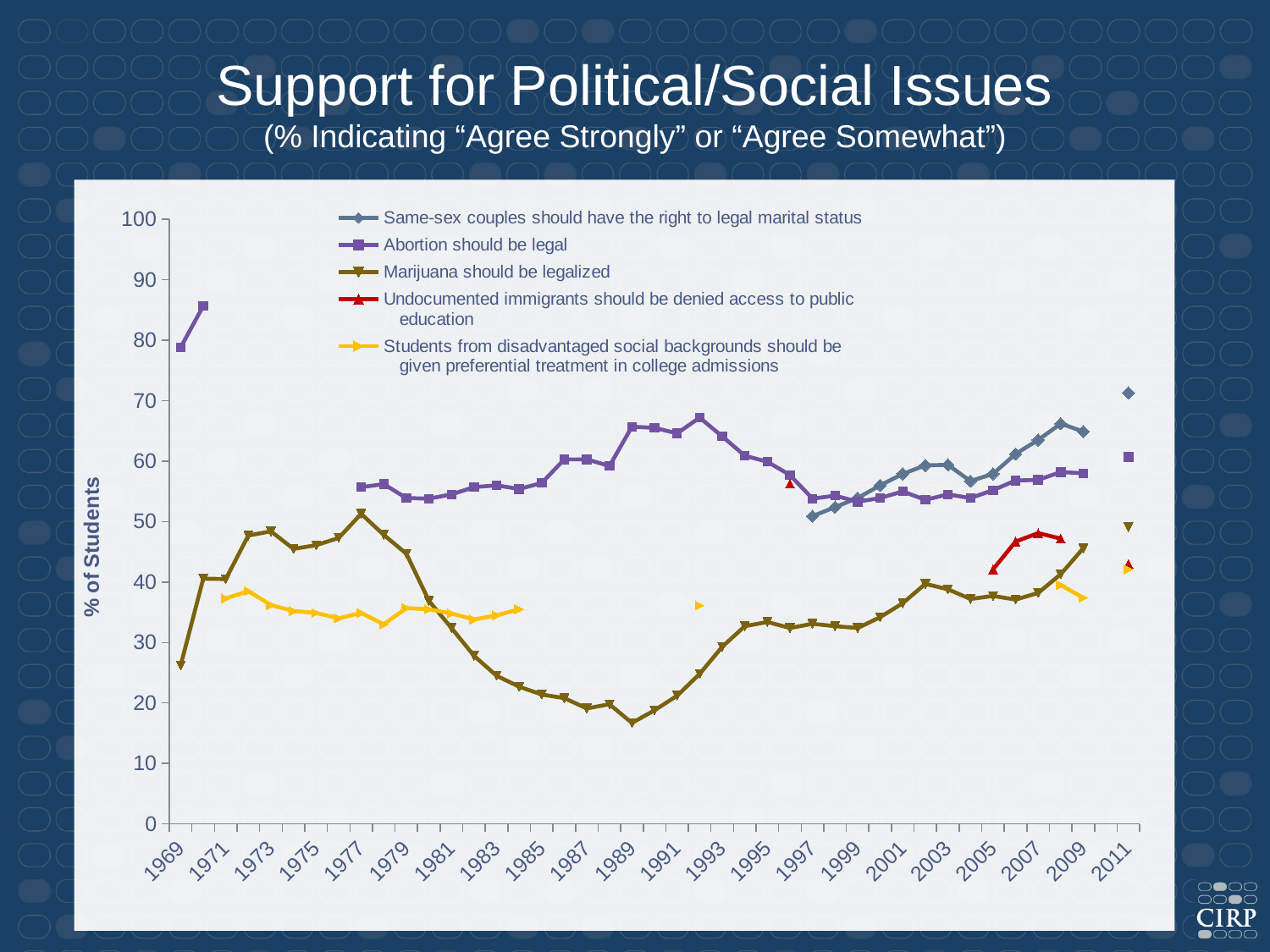
Is the value for 'Marijuana should be legalized' in 1989 greater or less than 20? less Is the value for 'Marijuana should be legalized' in 1969 greater or less than 30? less In 2011, which is higher: 'Same-sex couples should have the right to legal marital status' or 'Abortion should be legal'? Same-sex couples should have the right to legal marital status What is the label on the vertical axis? % of Students What kind of chart is shown on the slide? line chart Which series has the highest value in 2011? Same-sex couples should have the right to legal marital status In 1969, which is higher: 'Abortion should be legal' or 'Marijuana should be legalized'? Abortion should be legal Is the value for 'Abortion should be legal' in 1970 greater or less than 80? greater Which series reaches the lowest value anywhere on the chart? Marijuana should be legalized How many series does the legend list? 5 Does the 'Same-sex couples should have the right to legal marital status' series generally rise or fall from 1997 to 2011? rise